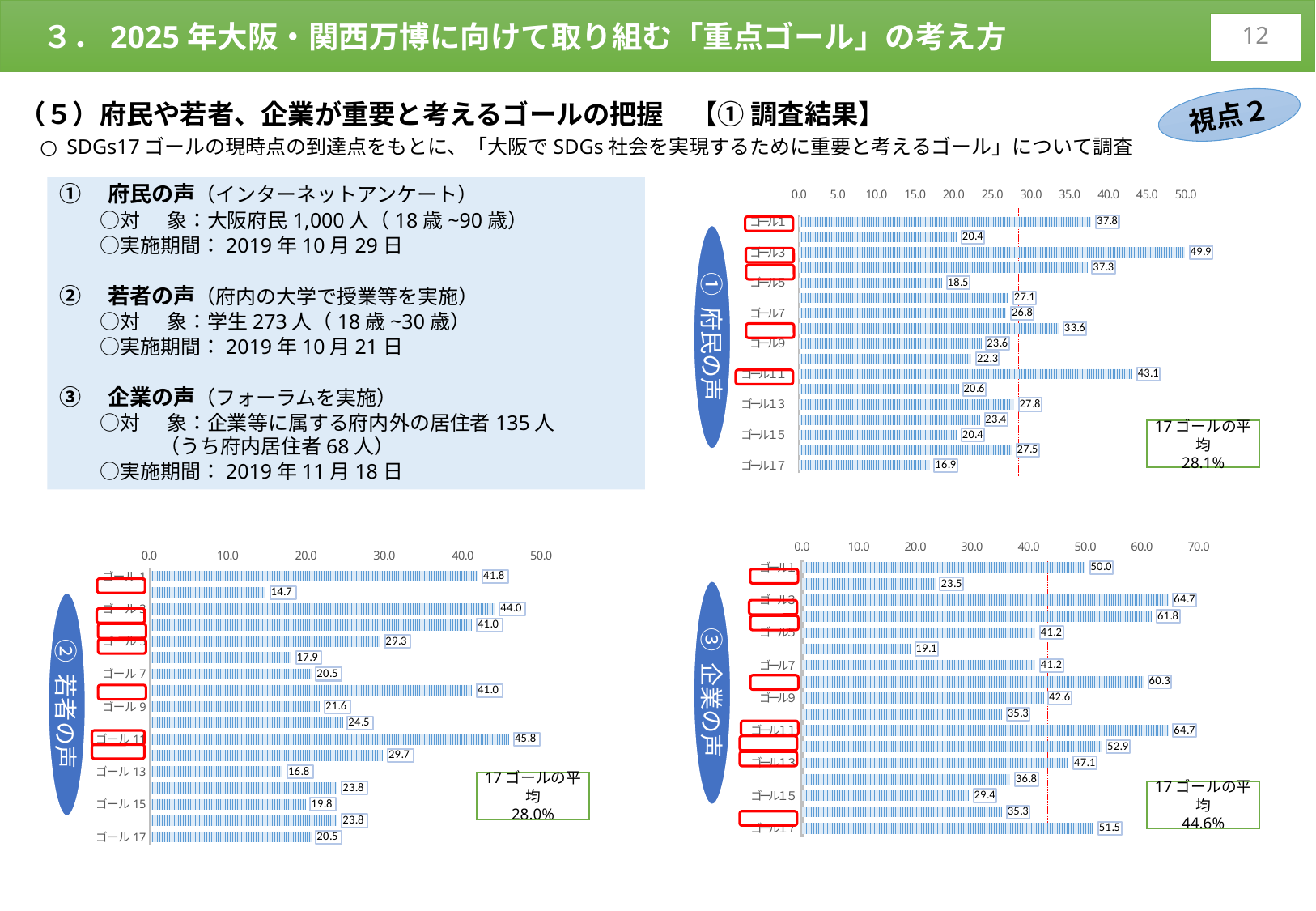
In the ① 府民の声 chart (top right), which goal has the highest value? ゴール3 In the ② 若者の声 chart (bottom left), what is the value for ゴール11? 45.8 In the ③ 企業の声 chart (bottom right), what is the value for ゴール1? 50.0 In the ① 府民の声 chart (top right), what is the value for ゴール3? 49.9 In the ① 府民の声 chart (top right), which is larger, the value for ゴール1 or the value for ゴール11? ゴール11 How many bars (goals) are plotted in the ③ 企業の声 chart (bottom right)? 17 In the ① 府民の声 chart (top right), what is the difference between the values for ゴール11 and ゴール1? 5.3 In the ② 若者の声 chart (bottom left), which goal has the highest value? ゴール11 In the ① 府民の声 chart (top right), which goal has the lowest value? ゴール17 What kind of chart is the ② 若者の声 chart (bottom left)? Bar chart In the ③ 企業の声 chart (bottom right), what is the difference between the values for ゴール3 and ゴール17? 13.2 In the ② 若者の声 chart (bottom left), is the value for ゴール13 greater or less than 20.0? less